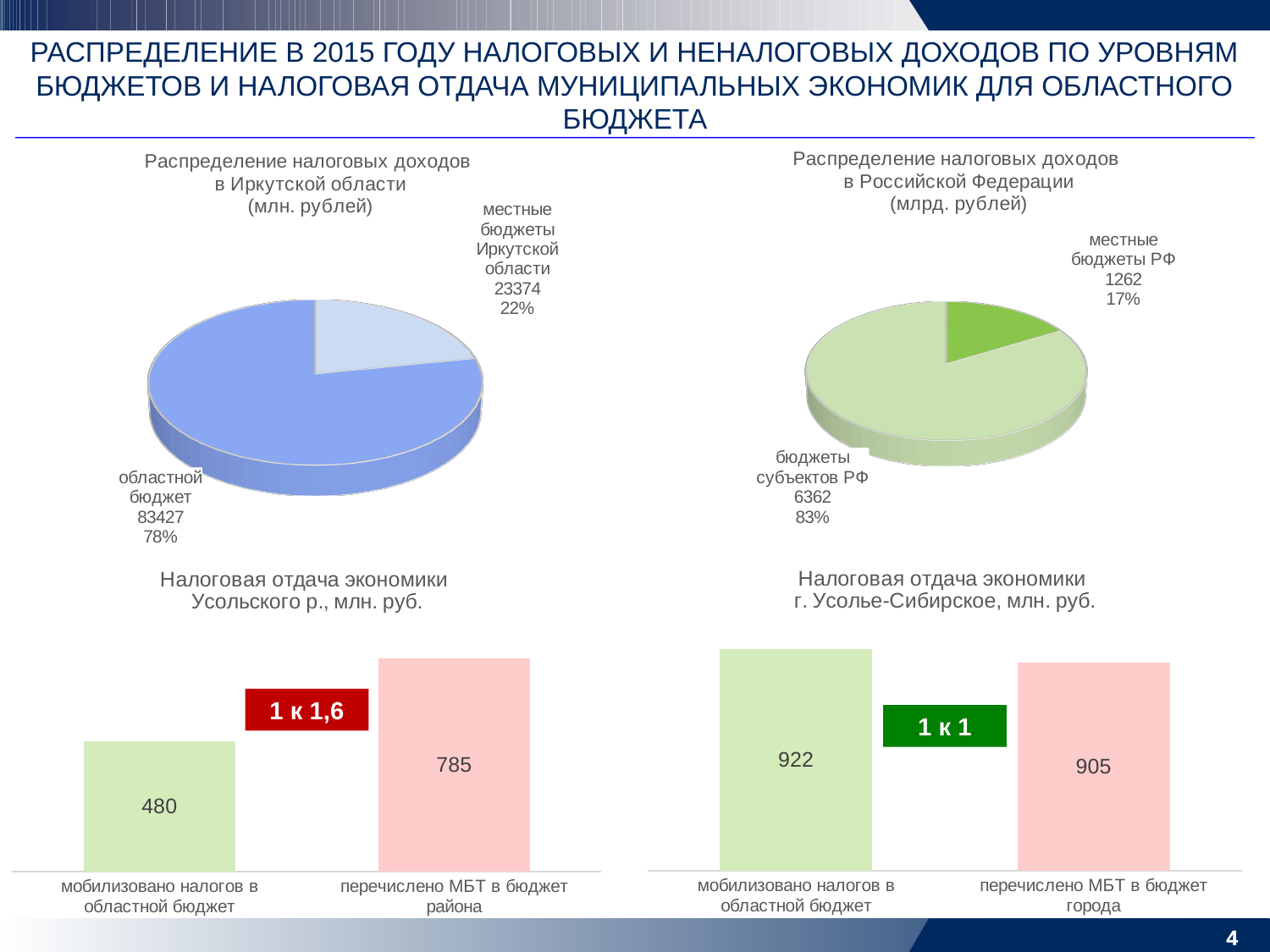
What kind of chart is 'Налоговая отдача экономики Усольского р., млн. руб.'? bar chart In the chart 'Налоговая отдача экономики Усольского р., млн. руб.', what is the difference between 'перечислено МБТ в бюджет района' and 'мобилизовано налогов в областной бюджет'? 305 What ratio label is printed between the bars in the chart 'Налоговая отдача экономики Усольского р., млн. руб.'? 1 к 1,6 In the chart 'Налоговая отдача экономики г. Усолье-Сибирское, млн. руб.', which is larger: 'мобилизовано налогов в областной бюджет' or 'перечислено МБТ в бюджет города'? мобилизовано налогов в областной бюджет In the pie chart 'Распределение налоговых доходов в Российской Федерации', what share of the pie does 'местные бюджеты РФ' take? 17% In the chart 'Налоговая отдача экономики Усольского р., млн. руб.', what is the value for 'перечислено МБТ в бюджет района'? 785 In the pie chart 'Распределение налоговых доходов в Иркутской области', what share of the pie does 'местные бюджеты Иркутской области' take? 22% In the pie chart 'Распределение налоговых доходов в Российской Федерации', what is the difference between 'бюджеты субъектов РФ' and 'местные бюджеты РФ'? 5100 In the pie chart 'Распределение налоговых доходов в Иркутской области', what value is shown for 'областной бюджет'? 83427 In the chart 'Налоговая отдача экономики г. Усолье-Сибирское, млн. руб.', what is the value for 'мобилизовано налогов в областной бюджет'? 922 In the pie chart 'Распределение налоговых доходов в Российской Федерации', what value is shown for 'бюджеты субъектов РФ'? 6362 In the pie chart 'Распределение налоговых доходов в Иркутской области', which slice is the largest? областной бюджет